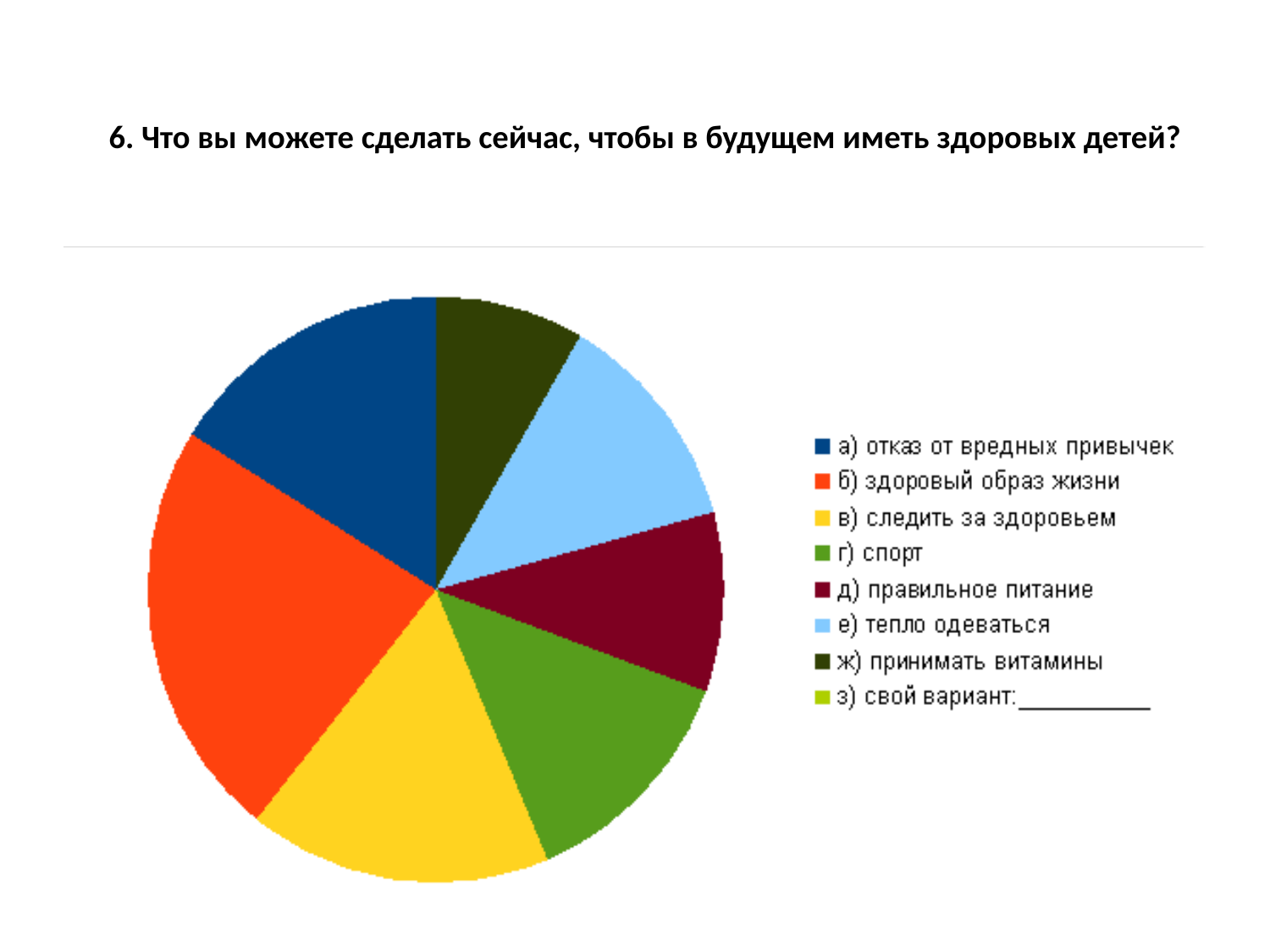
Which slice is larger: в) следить за здоровьем or д) правильное питание? в) следить за здоровьем Which slice is larger: а) отказ от вредных привычек or б) здоровый образ жизни? б) здоровый образ жизни Which slice is larger: б) здоровый образ жизни or в) следить за здоровьем? б) здоровый образ жизни Which category has the largest slice of the pie chart? б) здоровый образ жизни How many entries does the legend of the pie chart list? 8 How many slices are visible in the pie chart? 7 What is the title of the slide above the pie chart? 6. Что вы можете сделать сейчас, чтобы в будущем иметь здоровых детей? What colour is the slice for г) спорт in the pie chart? green What kind of chart is shown on the slide? pie chart